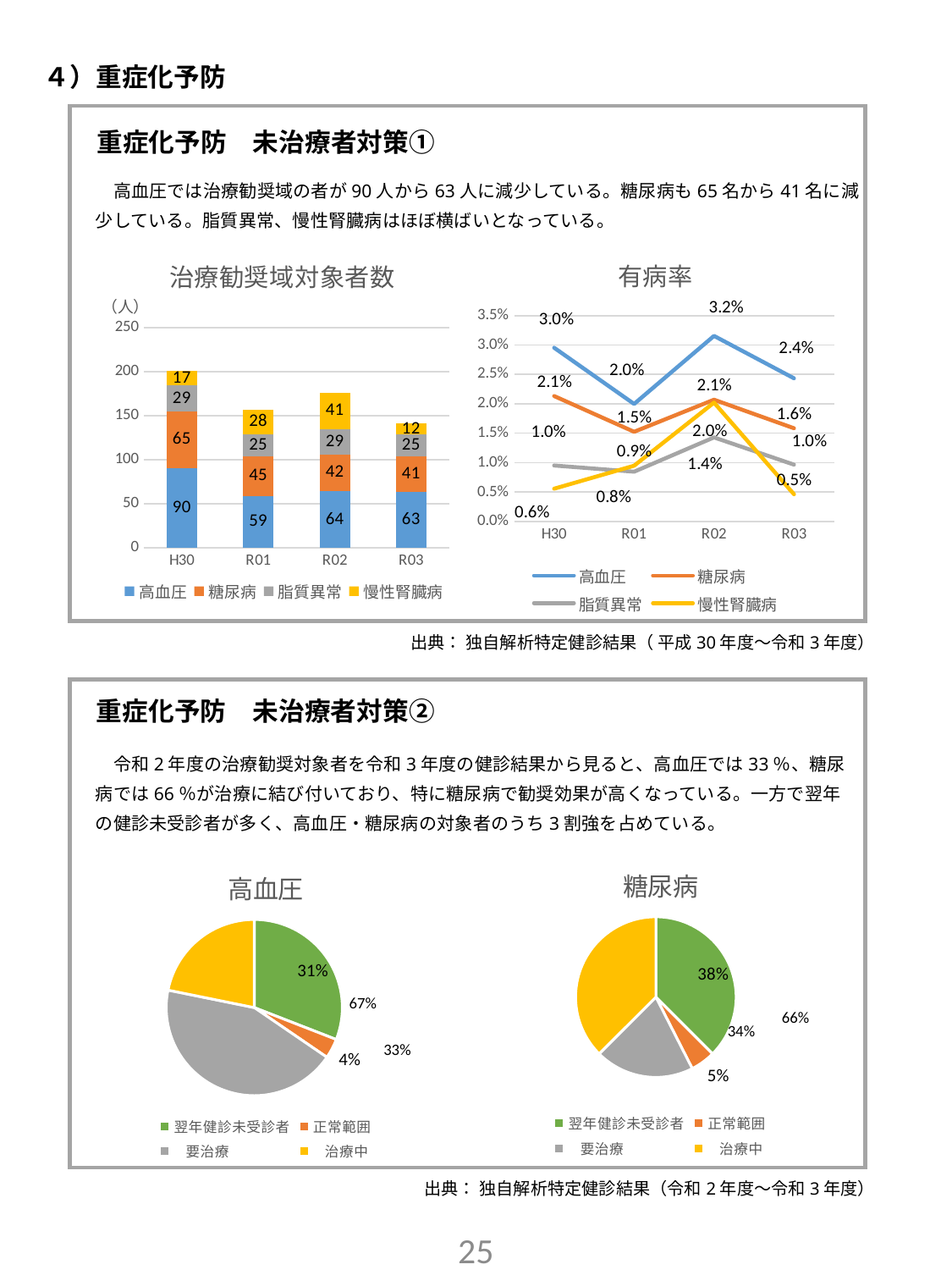
In the 有病率 chart, which year has the highest value for 慢性腎臓病? R02 In the 治療勧奨域対象者数 chart, what is the total of the stacked bar for R03? 141 In the 高血圧 pie chart, what is the share of the 翌年健診未受診者 slice? 31% In the 治療勧奨域対象者数 chart, how many series does the legend list? 4 In the 有病率 chart, how many years are shown on the x axis? 4 What kind of chart is the 治療勧奨域対象者数 chart? Stacked bar chart In the 糖尿病 pie chart, what is the share of the 翌年健診未受診者 slice? 38% In the 有病率 chart, what is the value for 高血圧 in R02? 3.2% In the 有病率 chart, which is larger in R01: 糖尿病 or 脂質異常? 糖尿病 In the 治療勧奨域対象者数 chart, what is the difference between the 糖尿病 values for H30 and R03? 24 In the 治療勧奨域対象者数 chart, what is the value for 慢性腎臓病 in R02? 41 In the 治療勧奨域対象者数 chart, what is the value for 高血圧 in H30? 90